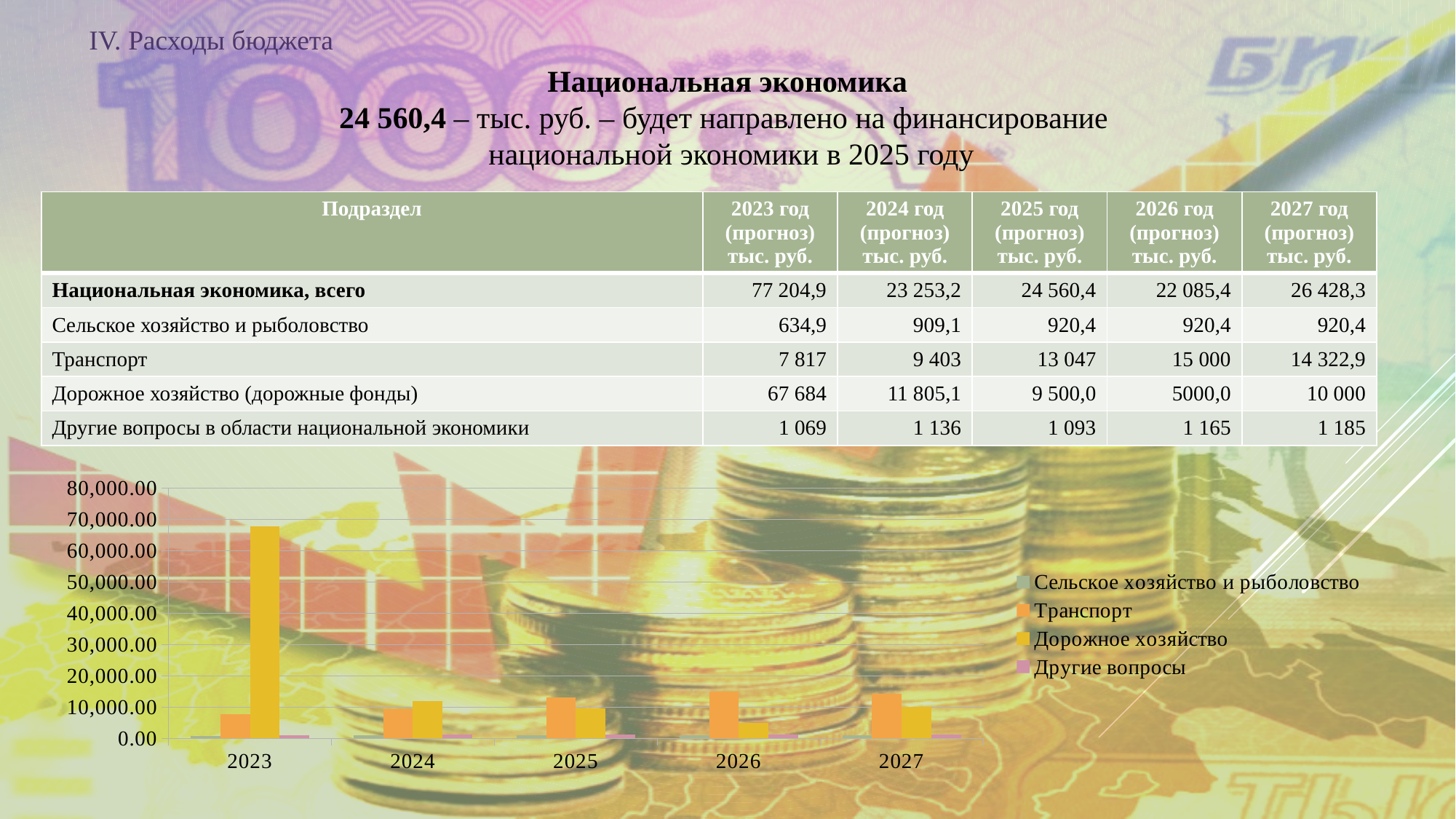
How many series does the chart's legend list? 4 Is the value for Транспорт in 2026 greater or less than 10,000.00? greater In which year is the bar for Дорожное хозяйство the tallest? 2023 According to the table on the slide, what is the value for Транспорт in 2025 (тыс. руб.)? 13 047 Is the value for Дорожное хозяйство in 2023 greater or less than 60,000.00? greater Do the bars for Транспорт rise or fall from 2023 to 2026? rise In 2024, which is larger: Транспорт or Дорожное хозяйство? Дорожное хозяйство Is the value for Дорожное хозяйство in 2026 greater or less than 10,000.00? less What kind of chart is shown at the bottom of the slide? bar chart In 2025, which is larger: Транспорт or Дорожное хозяйство? Транспорт What colour represents Транспорт in the chart's legend? orange How many years are shown along the x axis of the chart? 5